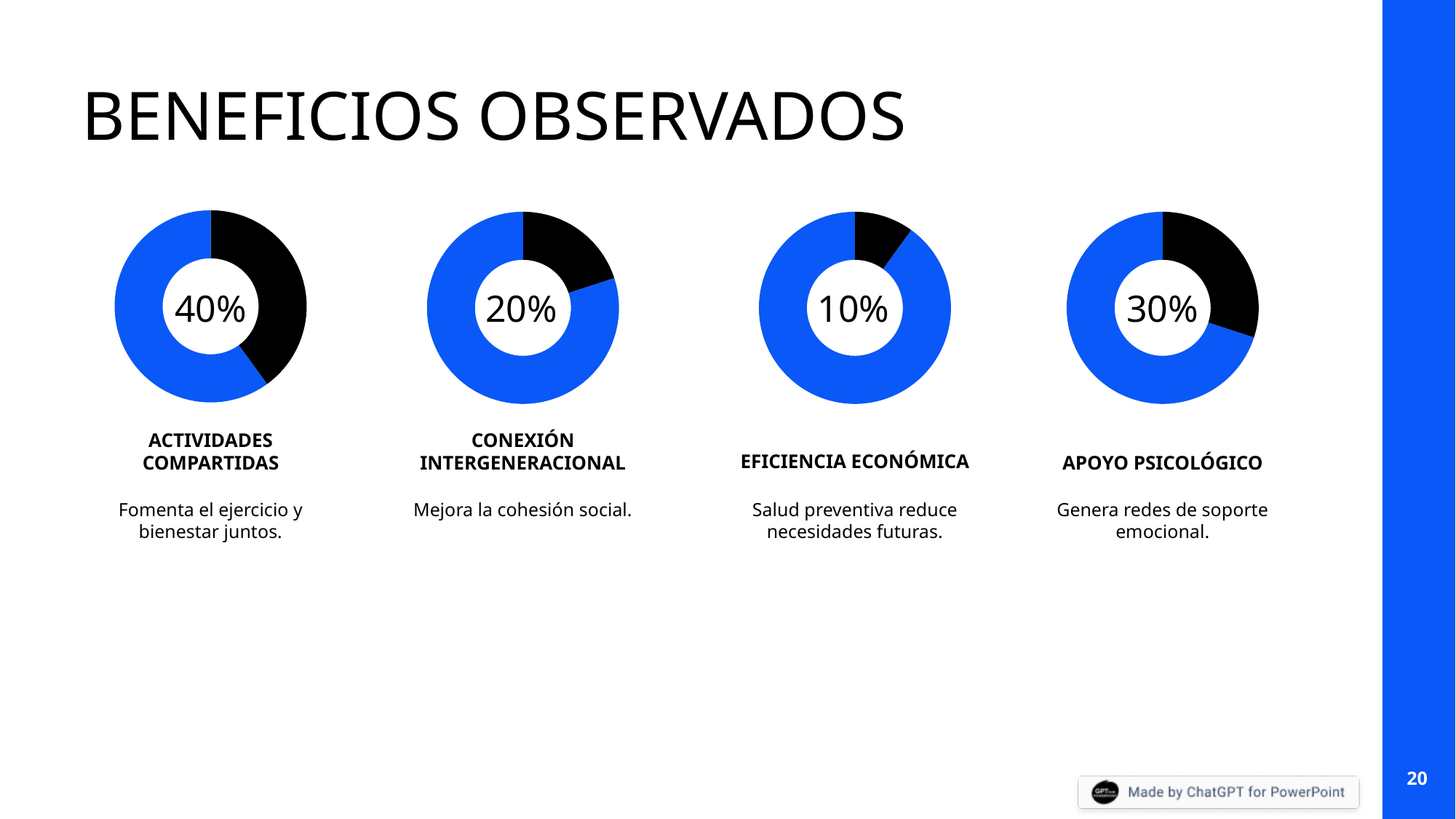
How many donut charts are shown on the slide? 4 Which of the four donut charts shows the highest percentage? Actividades compartidas Which is larger, the percentage for Apoyo psicológico or the percentage for Conexión intergeneracional? Apoyo psicológico What percentage is shown in the donut chart for Actividades compartidas? 40% Which of the four donut charts shows the lowest percentage? Eficiencia económica What kind of chart is used to show each percentage on the slide? Donut chart What percentage is shown in the donut chart for Conexión intergeneracional? 20% What percentage is shown in the donut chart for Eficiencia económica? 10% What is the title of the slide containing the four donut charts? BENEFICIOS OBSERVADOS What percentage is shown in the donut chart for Apoyo psicológico? 30% What is the difference between the percentage for Apoyo psicológico and the percentage for Conexión intergeneracional? 10% What is the difference between the percentage for Actividades compartidas and the percentage for Eficiencia económica? 30%